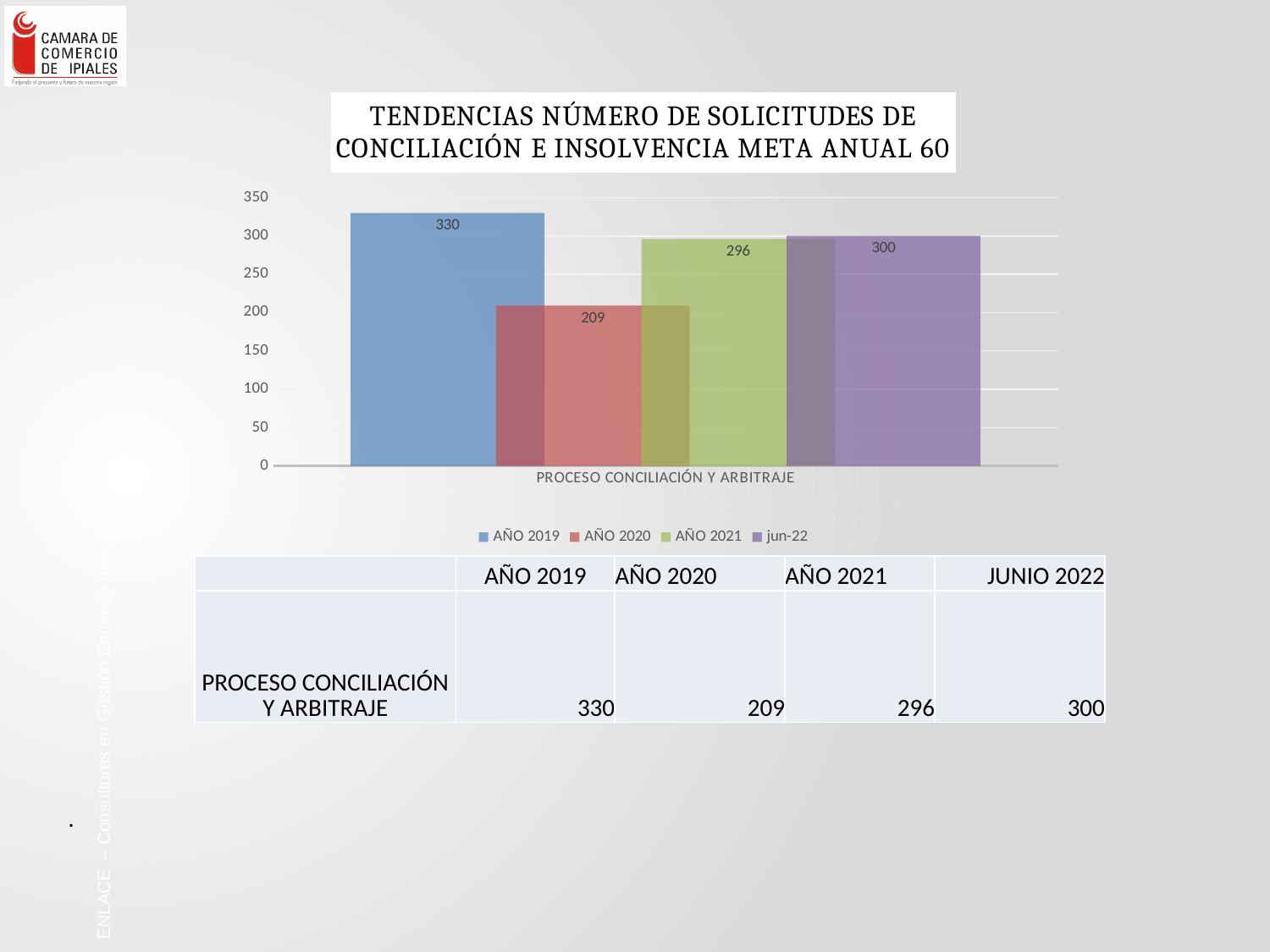
Which is larger, the value for AÑO 2019 or the value for jun-22? AÑO 2019 What kind of chart is shown on the slide? Bar chart How many series does the legend list? 4 What is the value for AÑO 2021 in the chart? 296 Which series has the lowest value in the chart? AÑO 2020 Which series has the highest value in the chart? AÑO 2019 What is the value for jun-22 in the chart? 300 What is the value for AÑO 2020 in the chart? 209 What is the category label shown on the x axis of the chart? PROCESO CONCILIACIÓN Y ARBITRAJE What is the value for AÑO 2019 in the chart? 330 What is the difference between the jun-22 value and the AÑO 2021 value? 4 What is the difference between the AÑO 2019 value and the AÑO 2020 value? 121